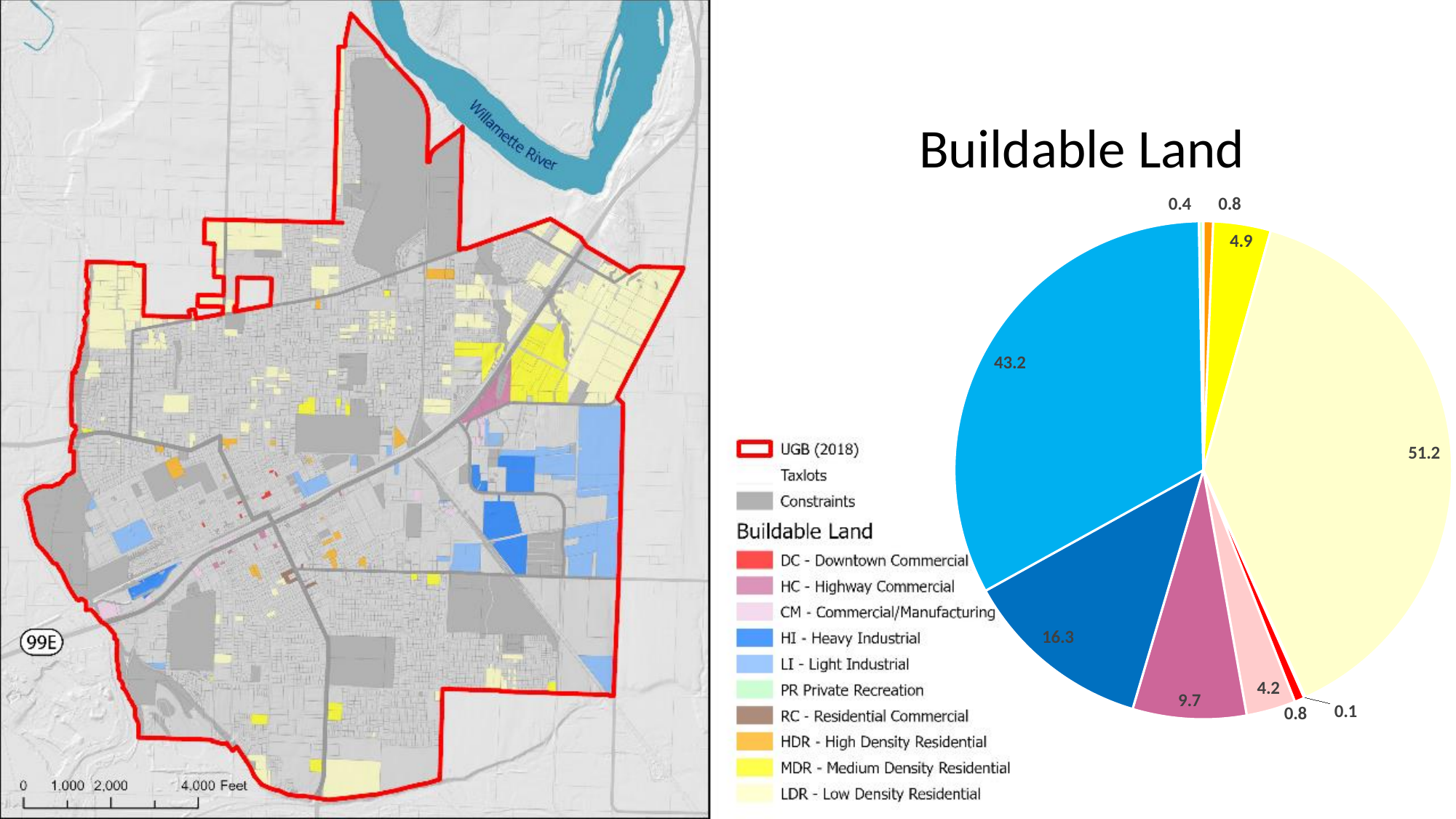
In the Buildable Land pie chart, what value is labelled on the bright yellow slice? 4.9 In the Buildable Land pie chart, what is the difference between the slices labelled 16.3 and 9.7? 6.6 How many slices does the Buildable Land pie chart have? 10 What is the title of the chart on the right of the slide? Buildable Land In the Buildable Land pie chart, what is the second-largest slice value? 43.2 What kind of chart is the Buildable Land chart on the right of the slide? pie chart In the Buildable Land pie chart, what is the value of the smallest slice? 0.1 In the Buildable Land pie chart, what value is labelled on the light blue slice? 43.2 In the Buildable Land pie chart, which is larger: the dark blue slice or the magenta slice? the dark blue slice (16.3) In the Buildable Land pie chart, what is the difference between the two largest slice values, 51.2 and 43.2? 8 In the Buildable Land pie chart, what is the value of the largest slice? 51.2 In the Buildable Land pie chart, how many slices have a labelled value below 1? 4